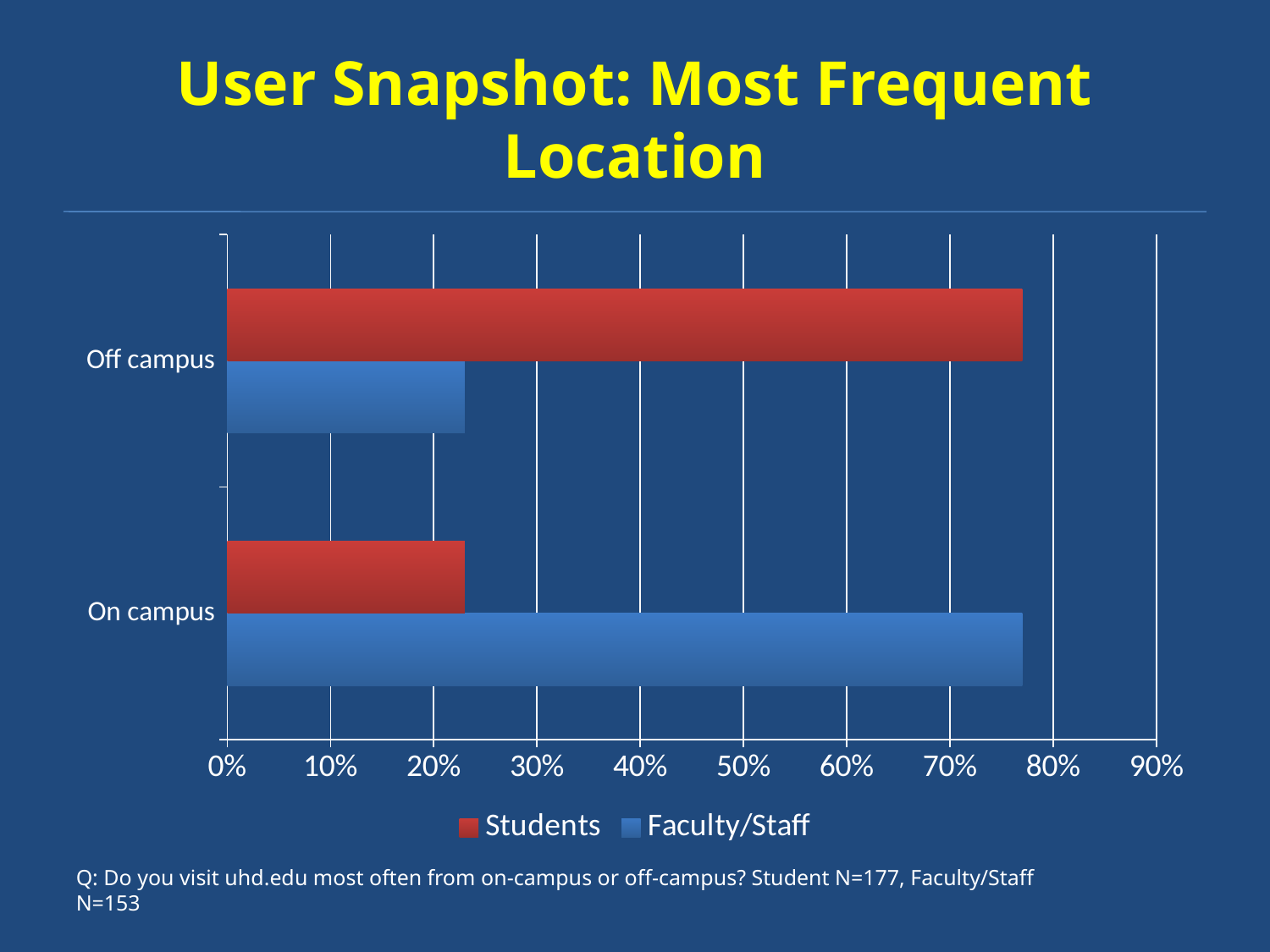
Is the Faculty/Staff value for Off campus greater or less than 30%? less How many categories are shown on the vertical axis? 2 For Off campus, which series has the larger value, Students or Faculty/Staff? Students Is the Faculty/Staff value for On campus greater or less than 70%? greater For which category is the Faculty/Staff value lowest? Off campus Is the Students value for On campus greater or less than 30%? less How many series does the legend list? 2 For On campus, which series has the larger value, Students or Faculty/Staff? Faculty/Staff For which category is the Students value highest? Off campus What kind of chart is shown on the slide? Bar chart Which colour represents the Faculty/Staff series in the legend? Blue